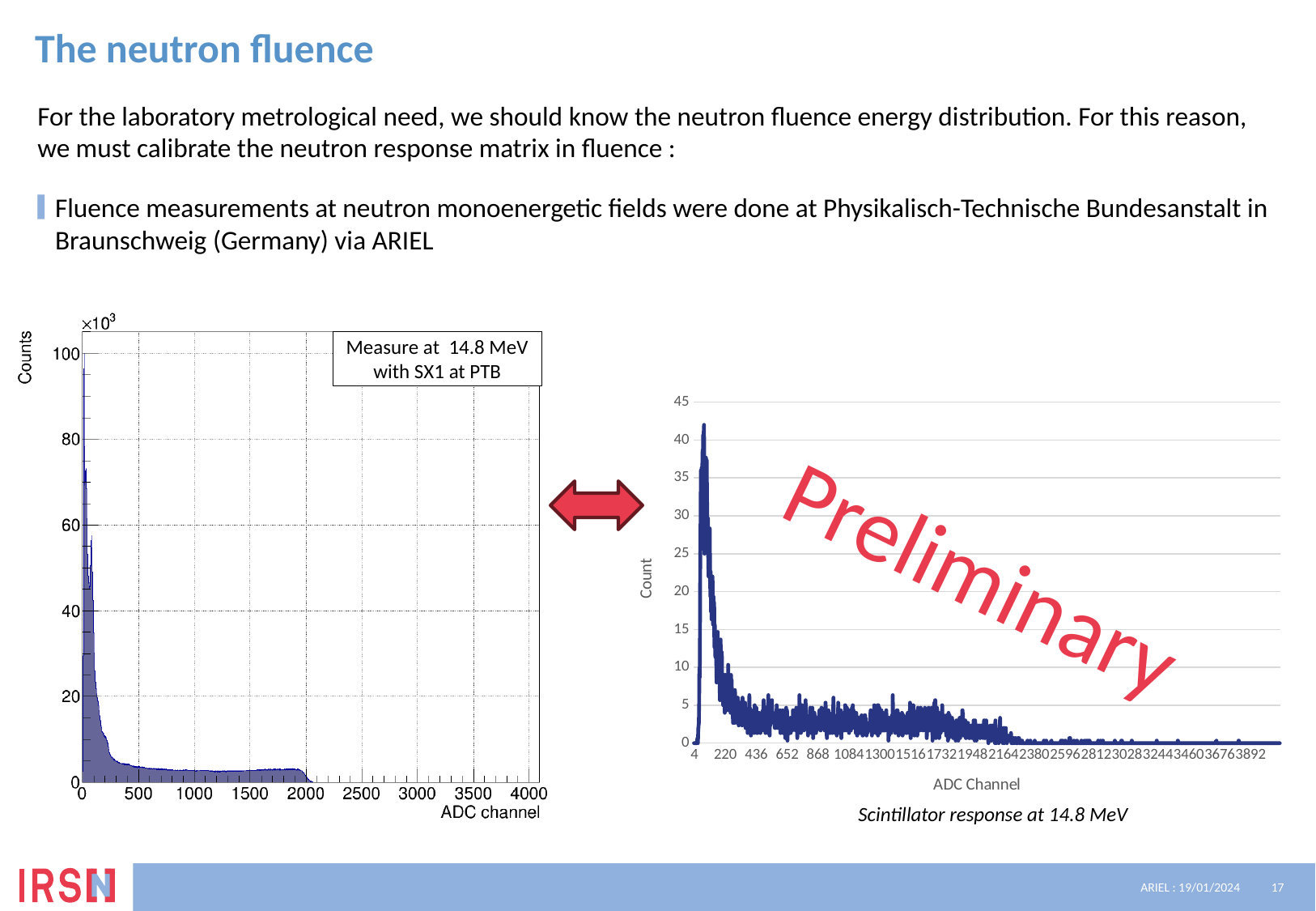
In the right chart, do the counts generally rise or fall as the ADC channel increases? fall What is the highest tick value shown on the x-axis of the left chart? 4000 What is the x-axis label of the left chart? ADC channel In the right chart, is the peak count greater or less than 35? greater What kind of chart is the right chart? line chart In the left chart, is the peak count greater or less than 80 (×10³)? greater What text is written in the box at the top of the left chart? Measure at 14.8 MeV with SX1 at PTB In the left chart, do the counts generally rise or fall as the ADC channel increases beyond the peak? fall